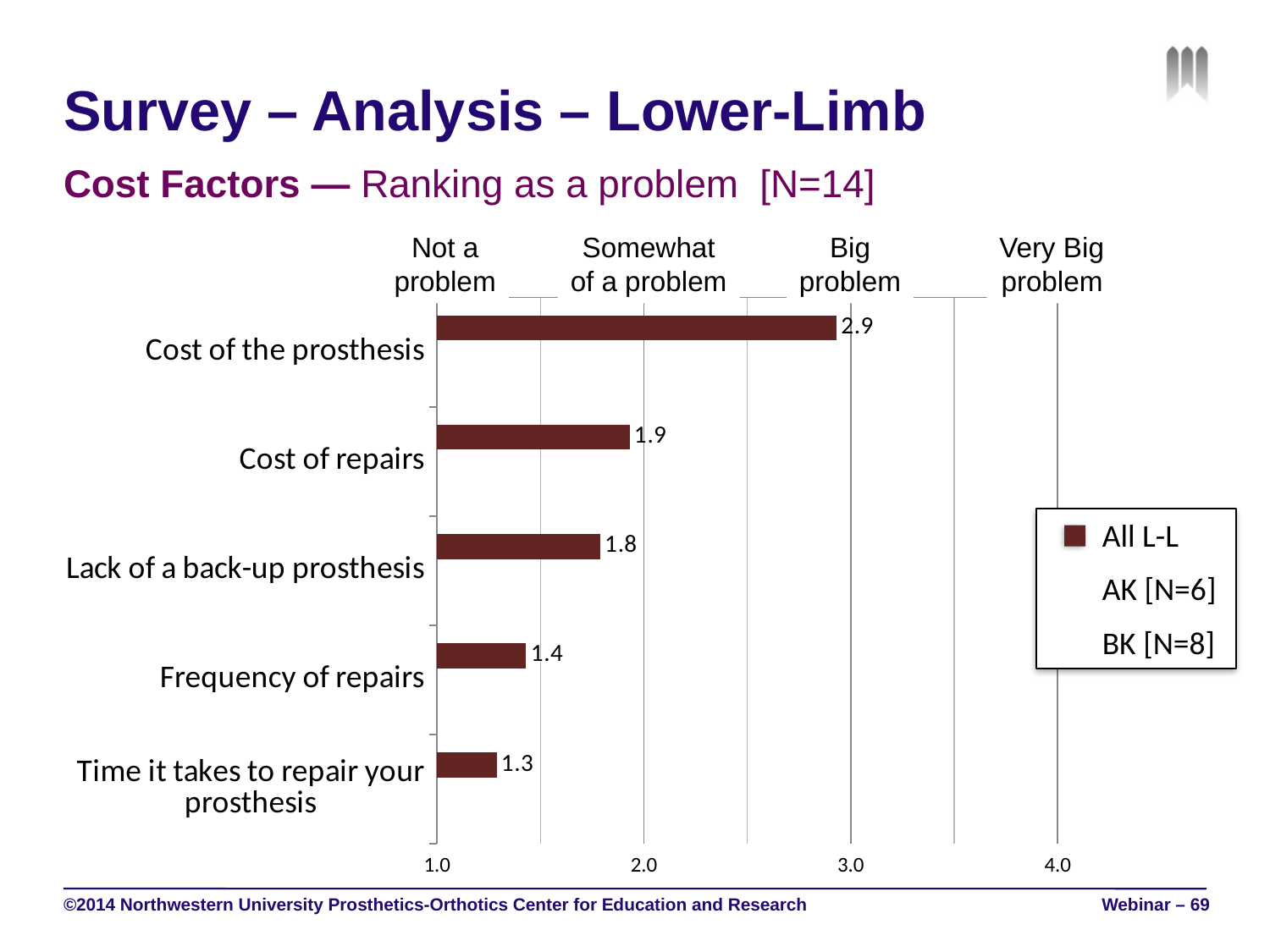
What is the value for Time it takes to repair your prosthesis? 1.3 Is the value for Cost of the prosthesis greater or less than 2.0? greater How many entries does the chart legend list? 3 Which cost factor has the highest ranking as a problem? Cost of the prosthesis What is the value for Lack of a back-up prosthesis? 1.8 How many cost factors are plotted in the chart? 5 What is the difference between the values for Cost of the prosthesis and Cost of repairs? 1.0 What is the value for Cost of the prosthesis? 2.9 Which is larger, the value for Frequency of repairs or the value for Lack of a back-up prosthesis? Lack of a back-up prosthesis Which cost factor has the lowest ranking as a problem? Time it takes to repair your prosthesis What kind of chart is shown on the slide? Bar chart What is the value for Cost of repairs? 1.9